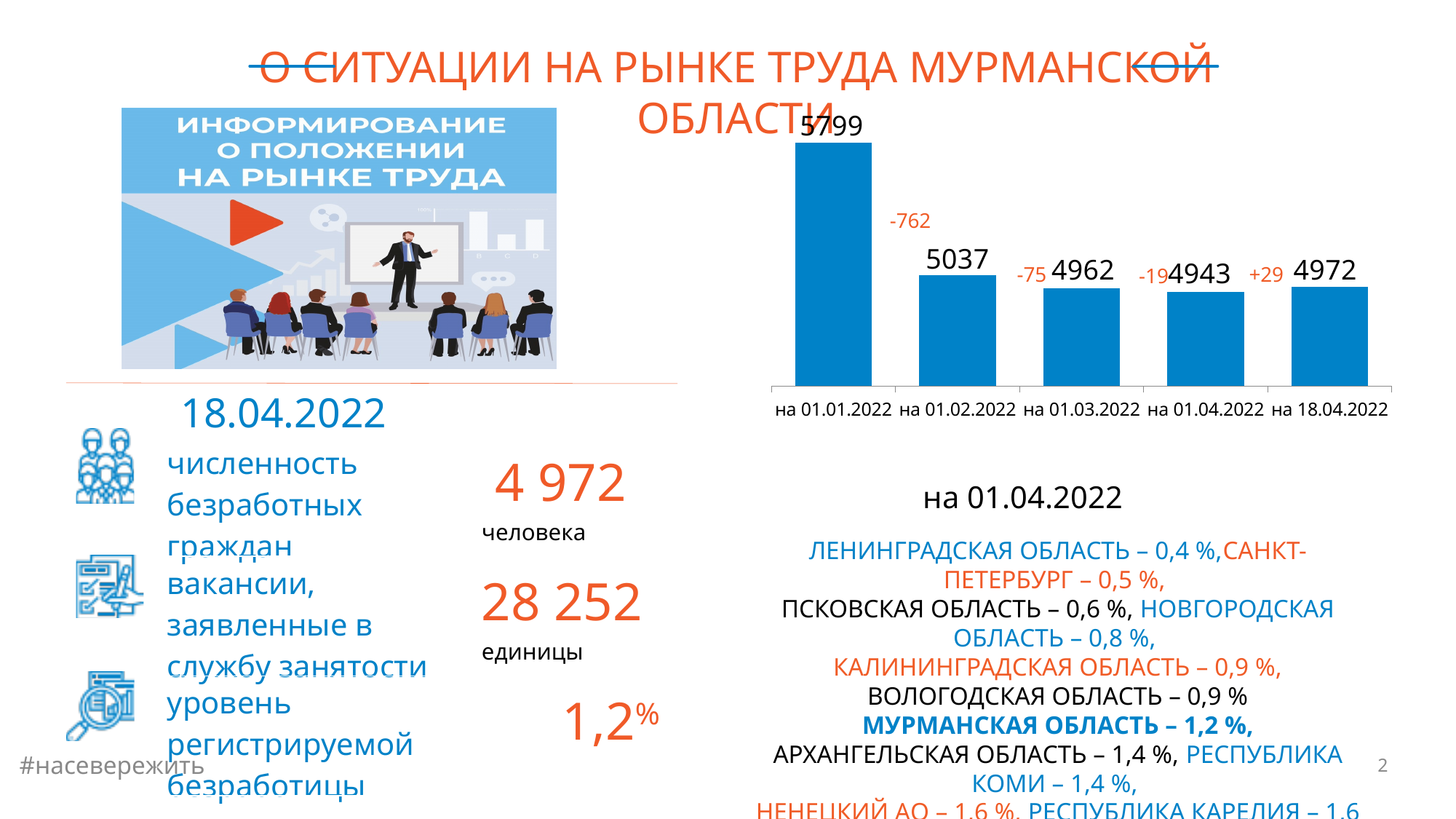
What is the value of the bar for на 18.04.2022? 4972 Which date has the lowest bar in the chart? на 01.04.2022 What is the value of the bar for на 01.03.2022? 4962 What type of chart is shown on the slide? bar chart How many bars are shown in the chart? 5 What is the value of the bar for на 01.02.2022? 5037 What is the value of the bar for на 01.04.2022? 4943 Which is larger, the value for на 01.02.2022 or the value for на 01.03.2022? на 01.02.2022 What is the difference between the values for на 18.04.2022 and на 01.04.2022? 29 What is the difference between the values for на 01.01.2022 and на 01.02.2022? 762 What is the value of the bar for на 01.01.2022? 5799 Which date has the highest bar in the chart? на 01.01.2022